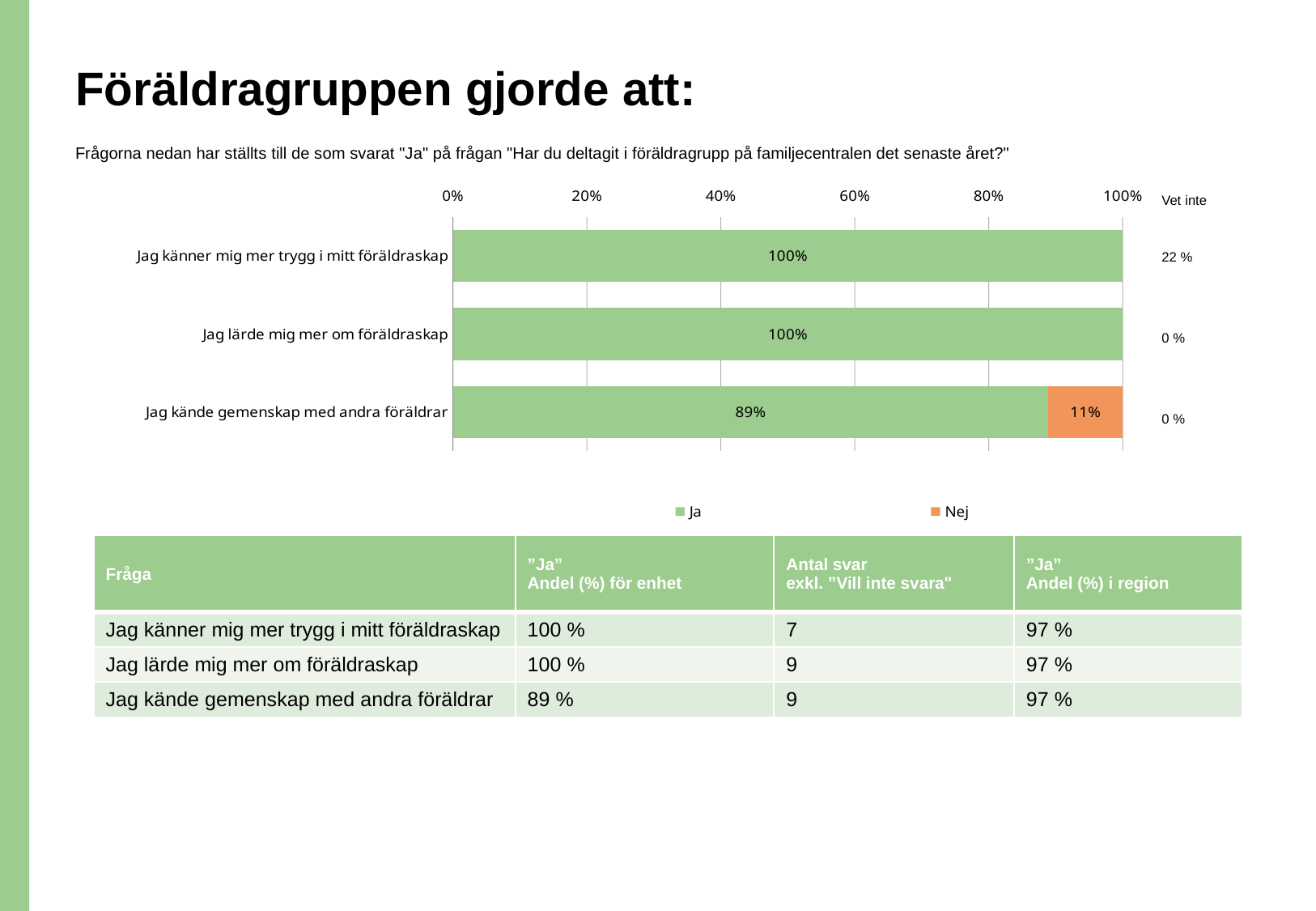
What is the "Ja" value for "Jag lärde mig mer om föräldraskap"? 100% How many categories are shown in the chart? 3 What colour represents the "Nej" series in the chart? orange What kind of chart is shown on the slide? bar chart What is the difference between the "Ja" and "Nej" values for "Jag kände gemenskap med andra föräldrar"? 78% What is the total of the stacked bar for "Jag kände gemenskap med andra föräldrar"? 100% What is the "Ja" value for "Jag känner mig mer trygg i mitt föräldraskap"? 100% Which category has the lowest "Ja" value? Jag kände gemenskap med andra föräldrar How many series does the legend list? 2 What is the "Nej" value for "Jag kände gemenskap med andra föräldrar"? 11% What is the "Ja" value for "Jag kände gemenskap med andra föräldrar"? 89% Is the "Ja" value for "Jag kände gemenskap med andra föräldrar" greater or less than 80%? greater